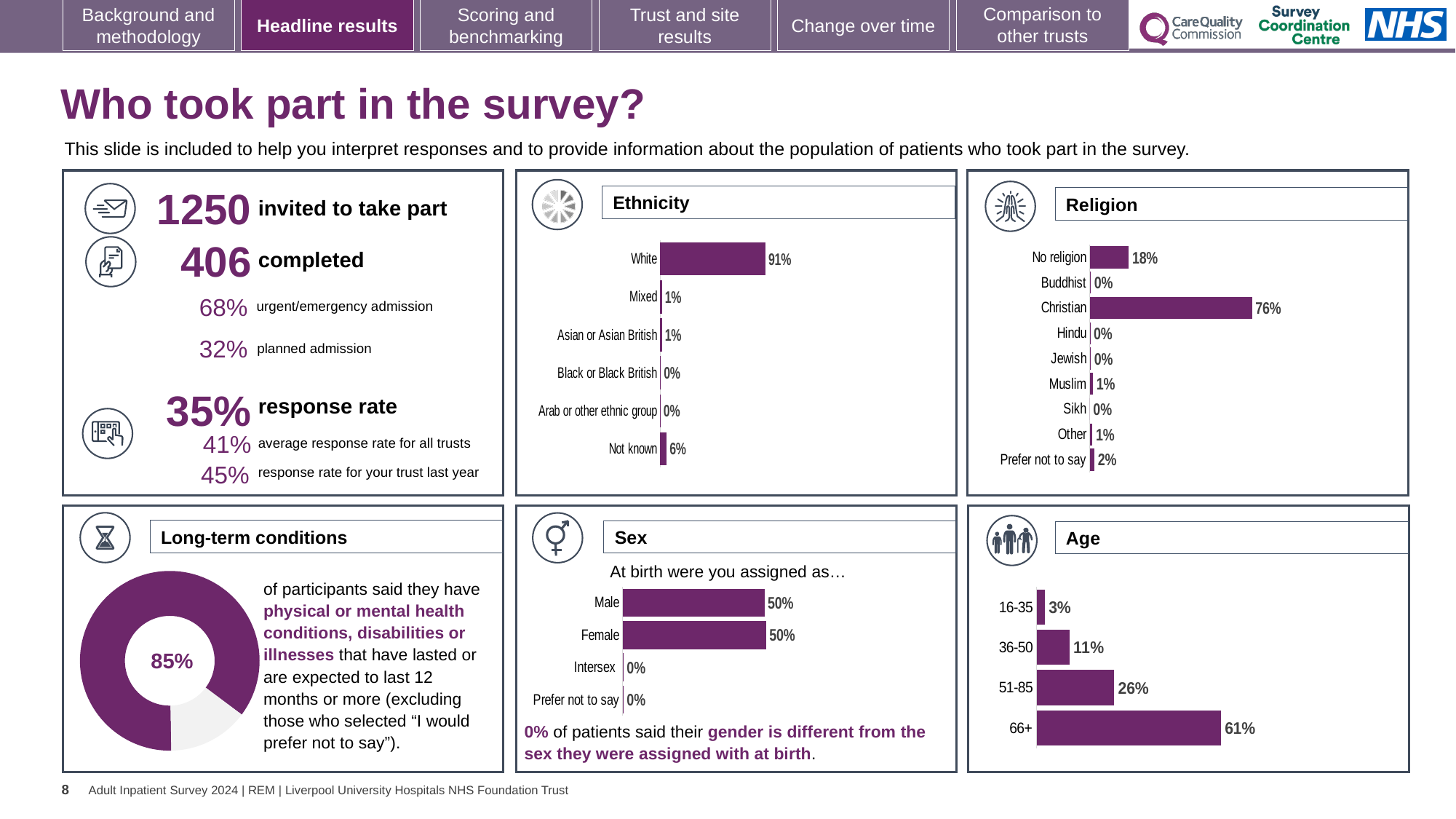
In the Age chart, which age group has the lowest value? 16-35 In the Age chart, do the values rise or fall as the age groups go from 16-35 to 66+? rise In the Religion chart, what is the value for Christian? 76% In the Ethnicity chart, which category has the highest value? White In the Age chart, which age group has the highest value? 66+ In the Religion chart, what is the difference between Christian and No religion? 58% In the Ethnicity chart, how many categories are shown? 6 In the Age chart, what is the difference between 66+ and 51-85? 35% In the Ethnicity chart, what is the value for White? 91% In the Sex chart, what is the value for Female? 50% What kind of chart is the Long-term conditions chart? doughnut chart In the Religion chart, how many categories are shown? 9